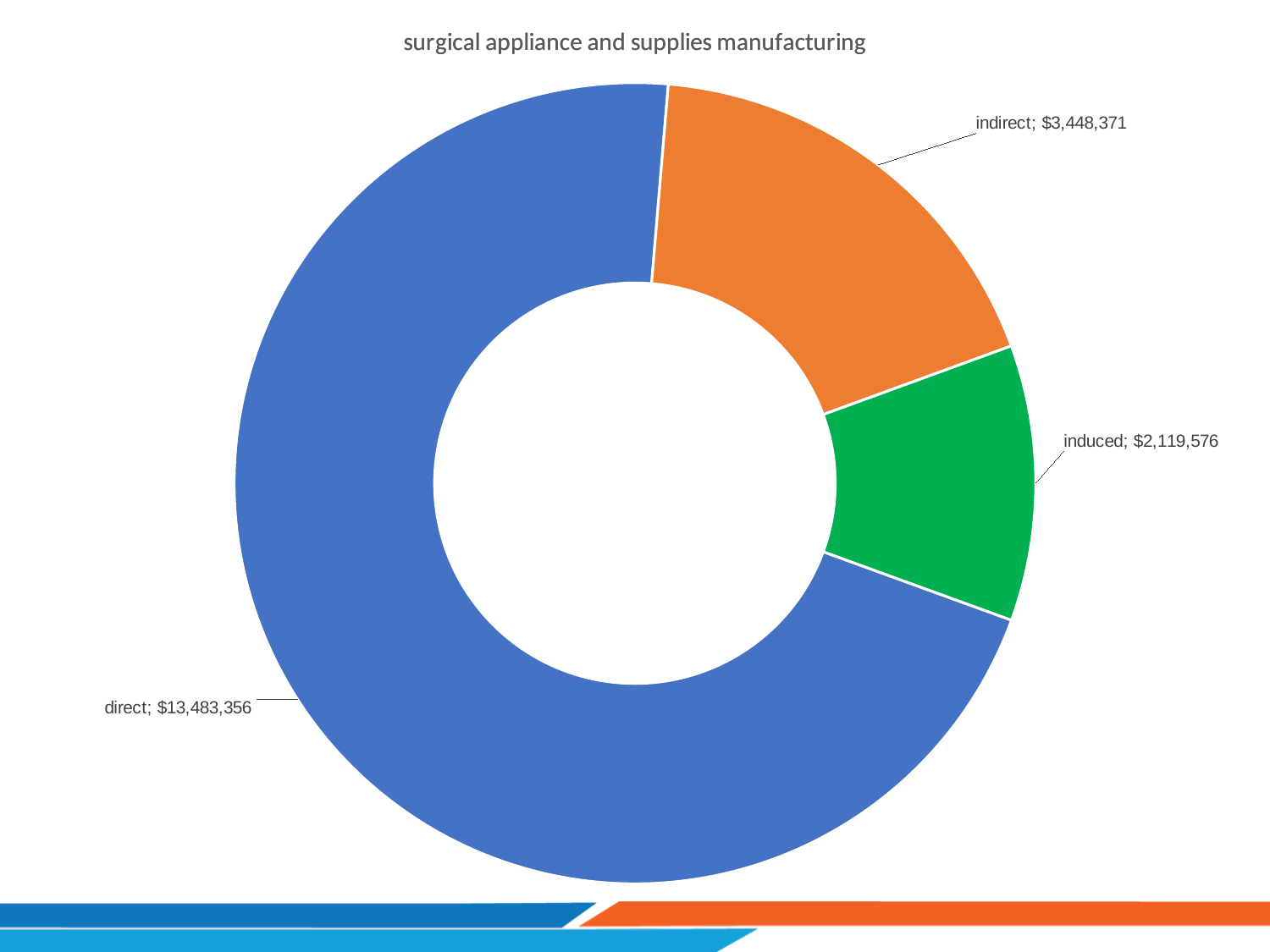
What kind of chart is this? doughnut (pie) chart What is the value for indirect? $3,448,371 What is the value for induced? $2,119,576 Which is larger, indirect or induced? indirect What is the value for direct? $13,483,356 What is the difference between the direct and indirect values? $10,034,985 What is the total of all three categories? $19,051,303 What is the difference between the indirect and induced values? $1,328,795 Which category has the smallest value? induced What is the title of the chart? surgical appliance and supplies manufacturing Which category has the largest value? direct How many categories are shown in the chart? 3